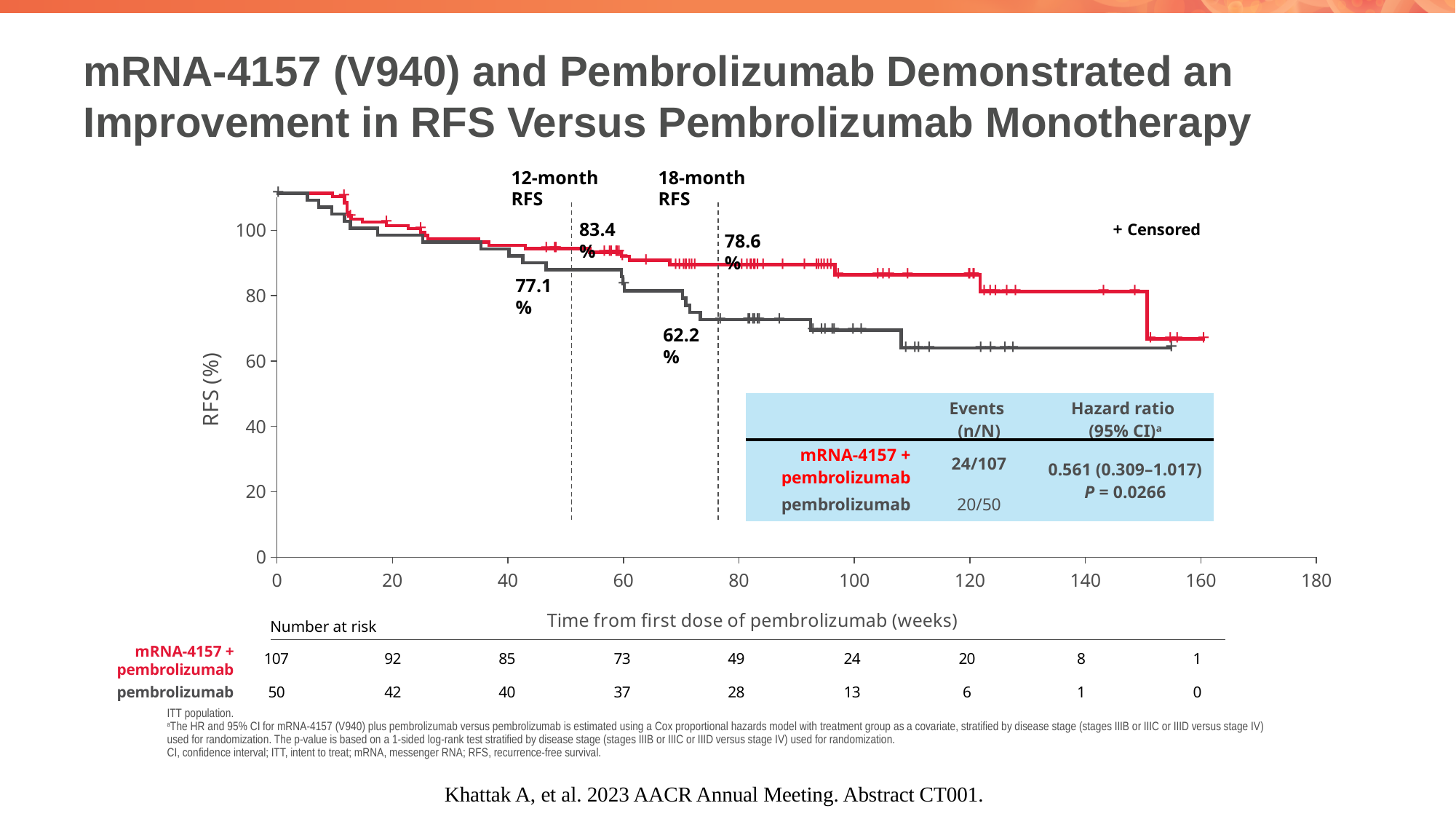
What is the 18-month RFS for the pembrolizumab monotherapy arm? 62.2% What kind of chart is shown on the slide? line chart (Kaplan-Meier survival curve) What is the 18-month RFS for the mRNA-4157 + pembrolizumab arm? 78.6% How many patients were at risk in the mRNA-4157 + pembrolizumab arm at week 80? 49 Which arm has the higher 18-month RFS? mRNA-4157 + pembrolizumab What is the difference between the two arms' 12-month RFS values? 6.3% Do the RFS curves rise or fall as time from first dose increases? fall What is the 12-month RFS for the mRNA-4157 + pembrolizumab arm? 83.4% What is the hazard ratio (95% CI) shown in the table? 0.561 (0.309–1.017) What is the difference between the two arms' 18-month RFS values? 16.4% What is the label of the x axis? Time from first dose of pembrolizumab (weeks) How many events (n/N) are reported for the pembrolizumab arm? 20/50